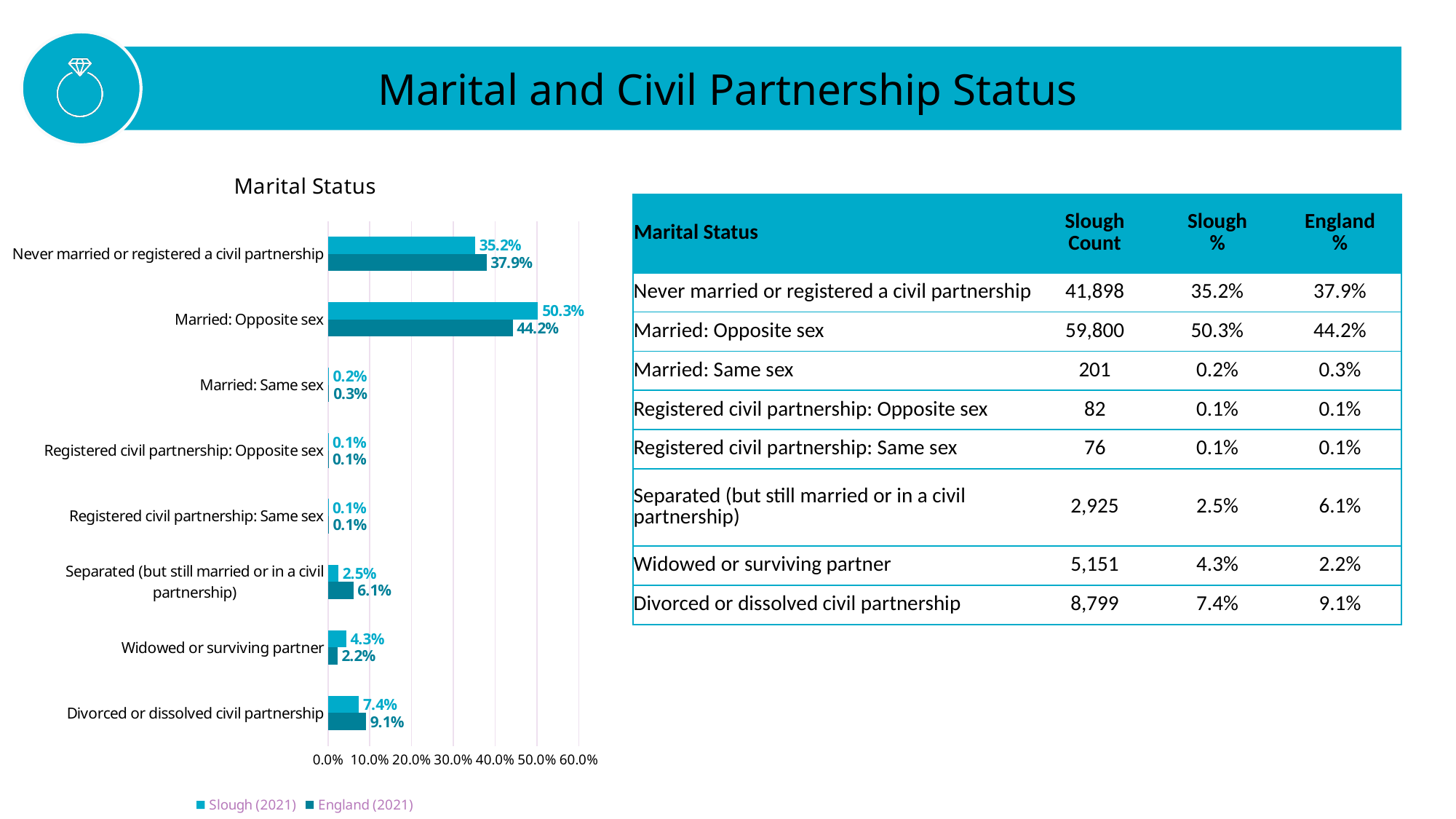
What type of chart is the Marital Status chart? Bar chart In the Marital Status chart, is the Slough (2021) value for Never married or registered a civil partnership greater or less than 30.0%? greater In the Marital Status chart, which category has the highest Slough (2021) value? Married: Opposite sex How many series does the legend of the Marital Status chart list? 2 How many categories are shown in the Marital Status chart? 8 In the Marital Status chart, what is the Slough (2021) value for Married: Opposite sex? 50.3% In the Marital Status chart, what is the England (2021) value for Never married or registered a civil partnership? 37.9% In the Marital Status chart, what is the difference between the England (2021) and Slough (2021) values for Divorced or dissolved civil partnership? 1.7% In the Marital Status chart, what is the England (2021) value for Separated (but still married or in a civil partnership)? 6.1% In the Marital Status chart, which category has the lowest England (2021) value? Registered civil partnership: Opposite sex and Registered civil partnership: Same sex (both 0.1%) In the Marital Status chart, what is the difference between the Slough (2021) and England (2021) values for Married: Opposite sex? 6.1% In the Marital Status chart, which is larger for Widowed or surviving partner: the Slough (2021) value or the England (2021) value? Slough (2021)